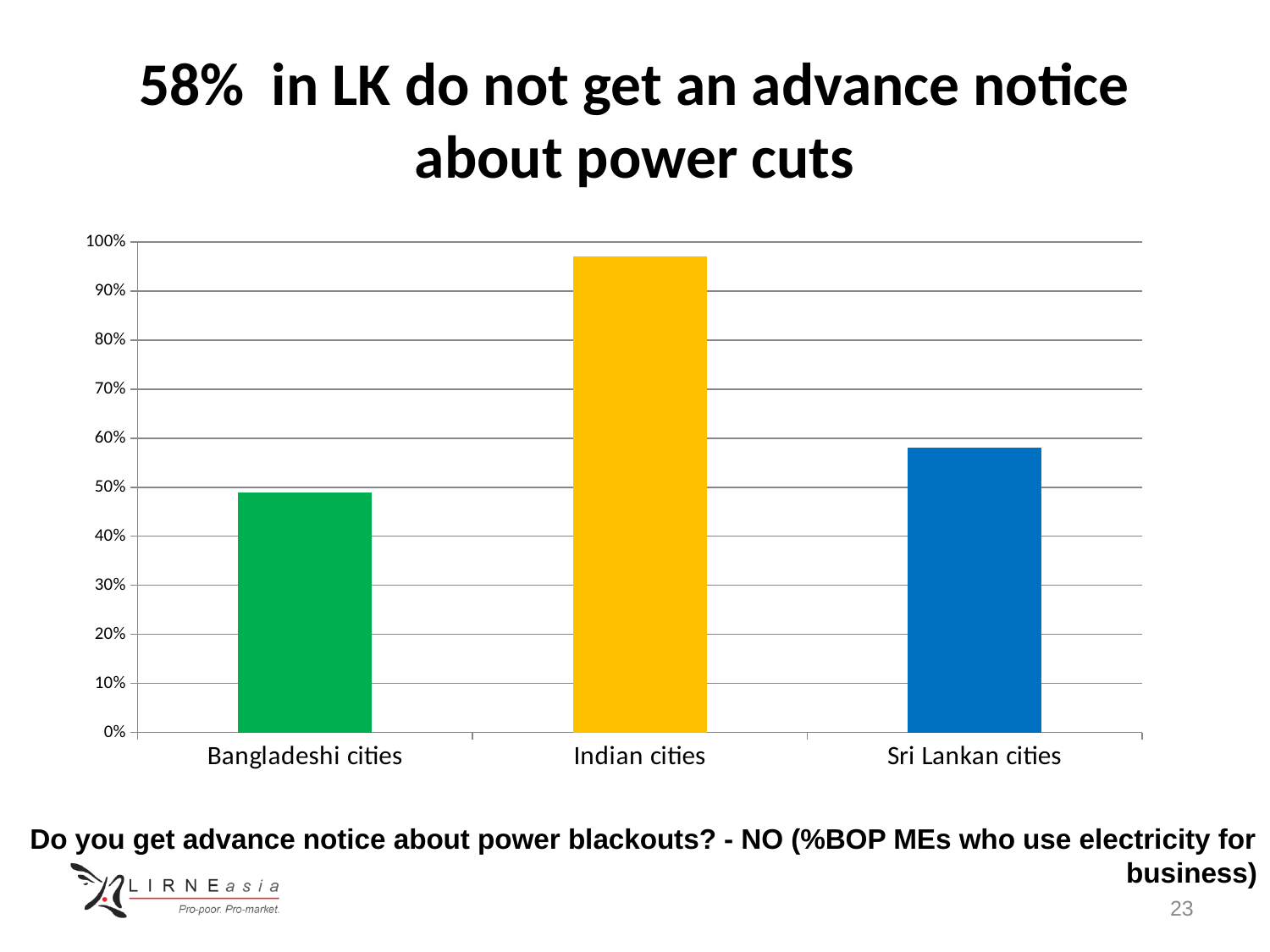
Is the value for Sri Lankan cities greater or less than 50%? greater What colour is the bar for Indian cities? yellow Is the value for Indian cities greater or less than 90%? greater What type of chart is shown on the slide? bar chart According to the slide, what percentage of respondents in Sri Lanka (LK) do not get an advance notice about power cuts? 58% Which category has the lowest value in the chart? Bangladeshi cities Is the value for Bangladeshi cities greater or less than 40%? greater How many categories are shown on the x axis of the chart? 3 Which category has the highest value in the chart? Indian cities Which is larger, the value for Sri Lankan cities or the value for Bangladeshi cities? Sri Lankan cities Which is larger, the value for Indian cities or the value for Sri Lankan cities? Indian cities